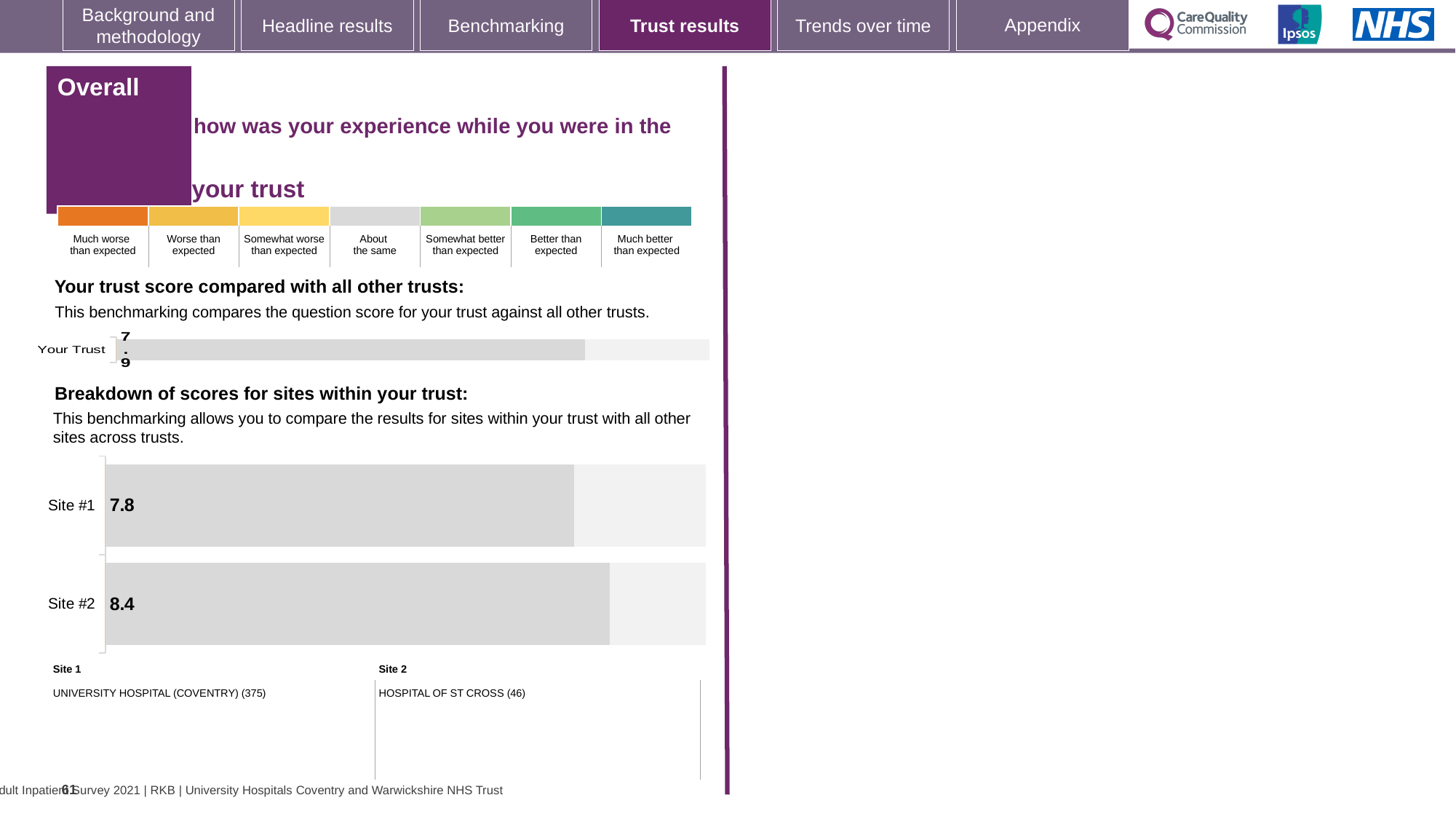
In the 'Breakdown of scores for sites within your trust' chart, which site has the highest score? Site #2 How many bars are shown in the 'Your trust score compared with all other trusts' chart? 1 In the 'Breakdown of scores for sites within your trust' chart, what is the score for Site #1? 7.8 What kind of chart is the 'Breakdown of scores for sites within your trust' chart? Bar chart In the 'Your trust score compared with all other trusts' chart, what is the score for Your Trust? 7.9 In the 'Breakdown of scores for sites within your trust' chart, what is the score for Site #2? 8.4 How many sites are shown in the 'Breakdown of scores for sites within your trust' chart? 2 In the 'Breakdown of scores for sites within your trust' chart, what is the difference between the scores of Site #2 and Site #1? 0.6 According to the key below the 'Breakdown of scores for sites within your trust' chart, which hospital is Site 2? HOSPITAL OF ST CROSS In the 'Breakdown of scores for sites within your trust' chart, which has the larger score, Site #1 or Site #2? Site #2 According to the key below the 'Breakdown of scores for sites within your trust' chart, which hospital is Site 1? UNIVERSITY HOSPITAL (COVENTRY) In the 'Breakdown of scores for sites within your trust' chart, which site has the lowest score? Site #1